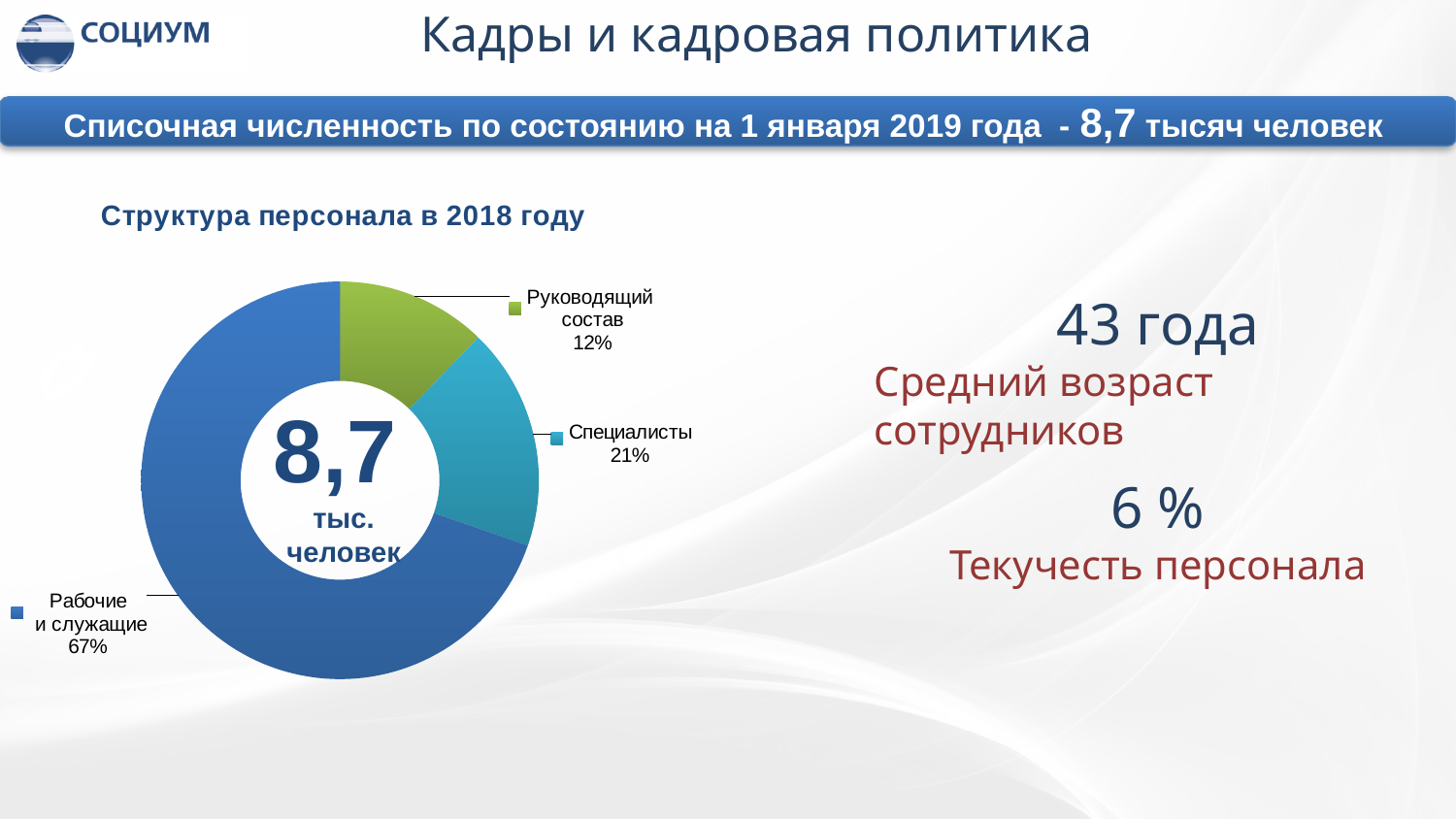
How many categories are shown in the 'Структура персонала в 2018 году' chart? 3 Which category has the smallest share in the 'Структура персонала в 2018 году' chart? Руководящий состав In the 'Структура персонала в 2018 году' chart, which share is larger: 'Специалисты' or 'Руководящий состав'? Специалисты What value is printed in the centre of the 'Структура персонала в 2018 году' chart? 8,7 тыс. человек In the 'Структура персонала в 2018 году' chart, what is the difference in percentage points between 'Специалисты' and 'Руководящий состав'? 9 What is the title of the chart on the slide? Структура персонала в 2018 году Which category has the largest share in the 'Структура персонала в 2018 году' chart? Рабочие и служащие What kind of chart is 'Структура персонала в 2018 году'? Pie (doughnut) chart What share of personnel is 'Рабочие и служащие' in the 'Структура персонала в 2018 году' chart? 67% What share of personnel is 'Специалисты' in the 'Структура персонала в 2018 году' chart? 21% What share of personnel is 'Руководящий состав' in the 'Структура персонала в 2018 году' chart? 12% In the 'Структура персонала в 2018 году' chart, what is the difference in percentage points between 'Рабочие и служащие' and 'Специалисты'? 46